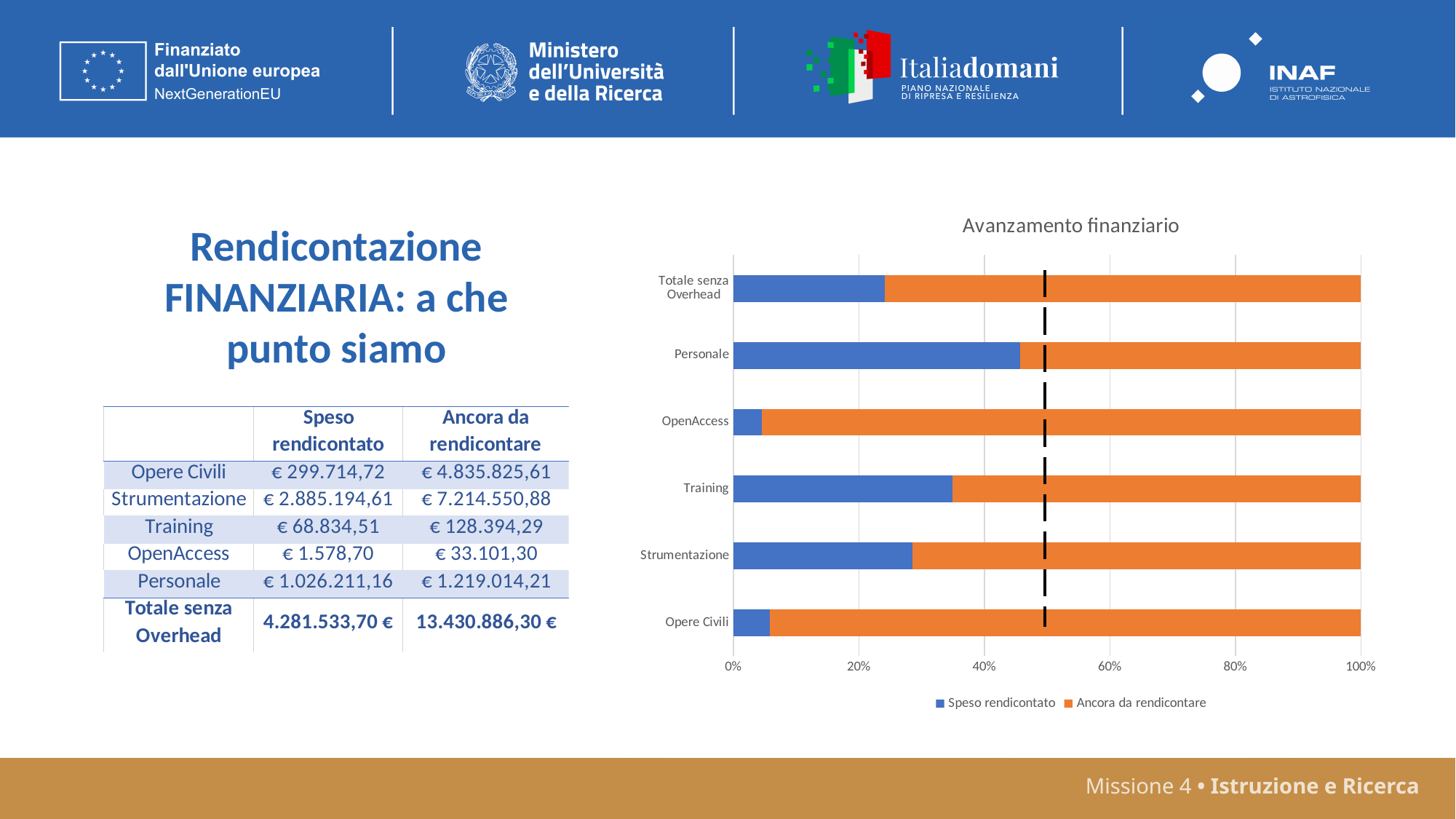
Is the 'Speso rendicontato' share for Strumentazione greater or less than 20%? greater What kind of chart is shown on the slide? Bar chart What is the title of the chart? Avanzamento finanziario How many series does the chart legend list? 2 Which category has the largest share of 'Speso rendicontato'? Personale Is the 'Speso rendicontato' share for OpenAccess greater or less than 20%? less Is the 'Speso rendicontato' share for Totale senza Overhead greater or less than 40%? less How many categories are plotted on the chart? 6 Which colour represents the series 'Speso rendicontato' in the chart? Blue Which has a larger 'Speso rendicontato' share, Training or Strumentazione? Training